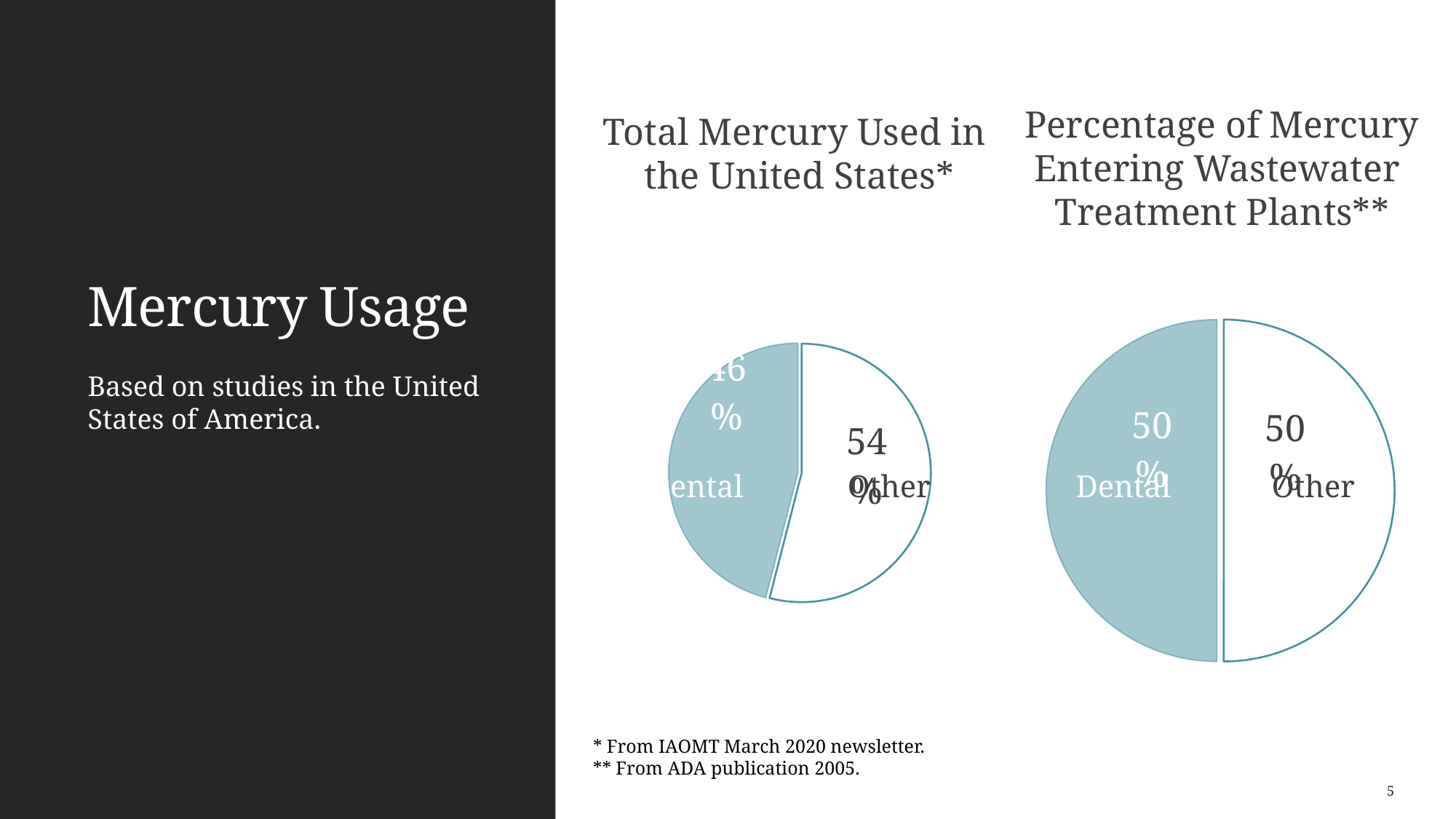
What type of chart is used for "Total Mercury Used in the United States"? pie chart In the "Total Mercury Used in the United States" chart, what percentage is labelled for Other? 54% In the "Percentage of Mercury Entering Wastewater Treatment Plants" chart, what percentage is labelled for Dental? 50% In the "Total Mercury Used in the United States" chart, how many percentage points larger is Other than Dental? 8 In the "Percentage of Mercury Entering Wastewater Treatment Plants" chart, what percentage is labelled for Other? 50% How many pie charts are shown on the slide? 2 In the "Total Mercury Used in the United States" chart, what percentage is labelled for Dental? 46% In the "Percentage of Mercury Entering Wastewater Treatment Plants" chart, how many slices does the pie have? 2 In the "Total Mercury Used in the United States" chart, which slice is the largest? Other In the "Percentage of Mercury Entering Wastewater Treatment Plants" chart, which slice is shaded teal? Dental In the "Total Mercury Used in the United States" chart, how many slices does the pie have? 2 In the "Total Mercury Used in the United States" chart, which slice is the smallest? Dental